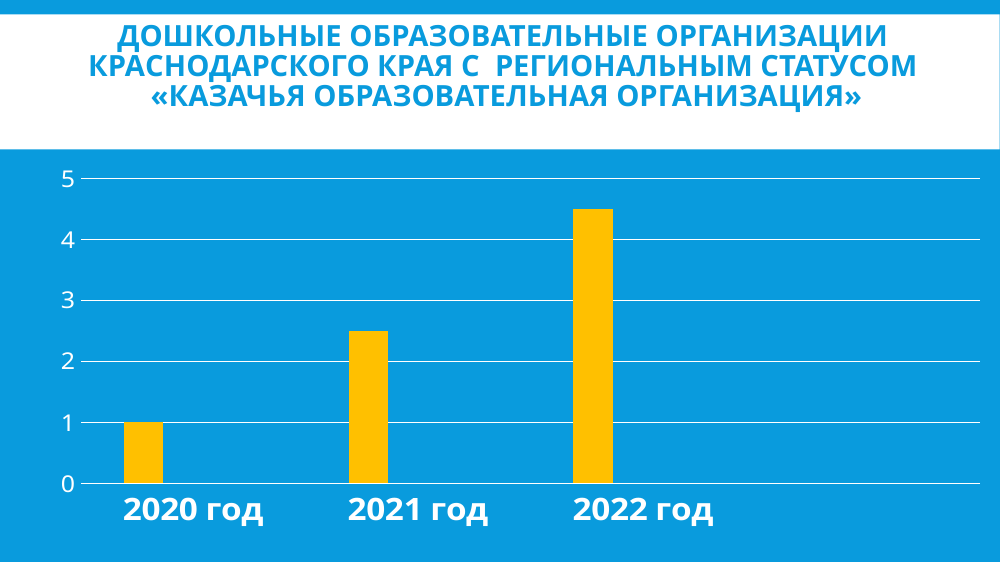
Which is larger, the value for 2021 год or the value for 2022 год? 2022 год Which year has the lowest bar? 2020 год Is the value for 2022 год greater or less than 4? greater Which year has the highest bar? 2022 год What kind of chart is shown on the slide? bar chart Is the value for 2021 год greater or less than 3? less How many categories (years) are shown on the x axis? 3 Is the value for 2022 год greater or less than 5? less What is the value for 2020 год? 1 What is the highest tick value shown on the vertical axis? 5 Do the values rise or fall from 2020 год to 2022 год? rise